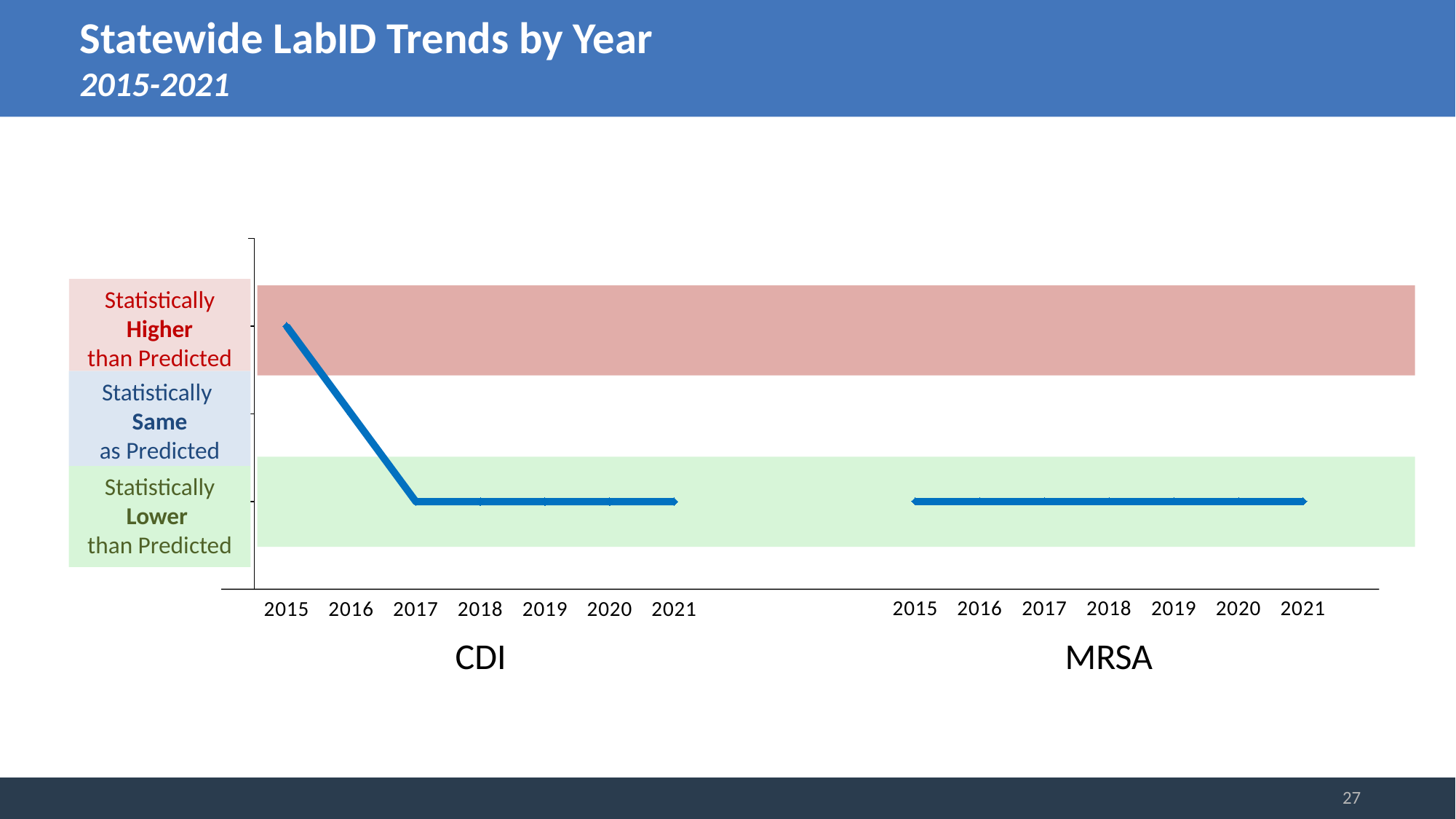
Which year has the highest CDI value? 2015 In which statistical band does the CDI value for 2021 fall? Statistically Lower than Predicted Does the CDI line rise or fall from 2015 to 2017? fall Which is higher, the CDI value for 2015 or the CDI value for 2019? 2015 Which two infection types are plotted along the x axis? CDI and MRSA What kind of chart is shown on the slide? line chart What is the title of the slide's chart? Statewide LabID Trends by Year 2015-2021 How many years are shown on the x axis for MRSA? 7 In which statistical band does the MRSA value for 2021 fall? Statistically Lower than Predicted In which statistical band does the MRSA value for 2015 fall? Statistically Lower than Predicted In which statistical band does the CDI value for 2015 fall? Statistically Higher than Predicted How many years are shown on the x axis for CDI? 7